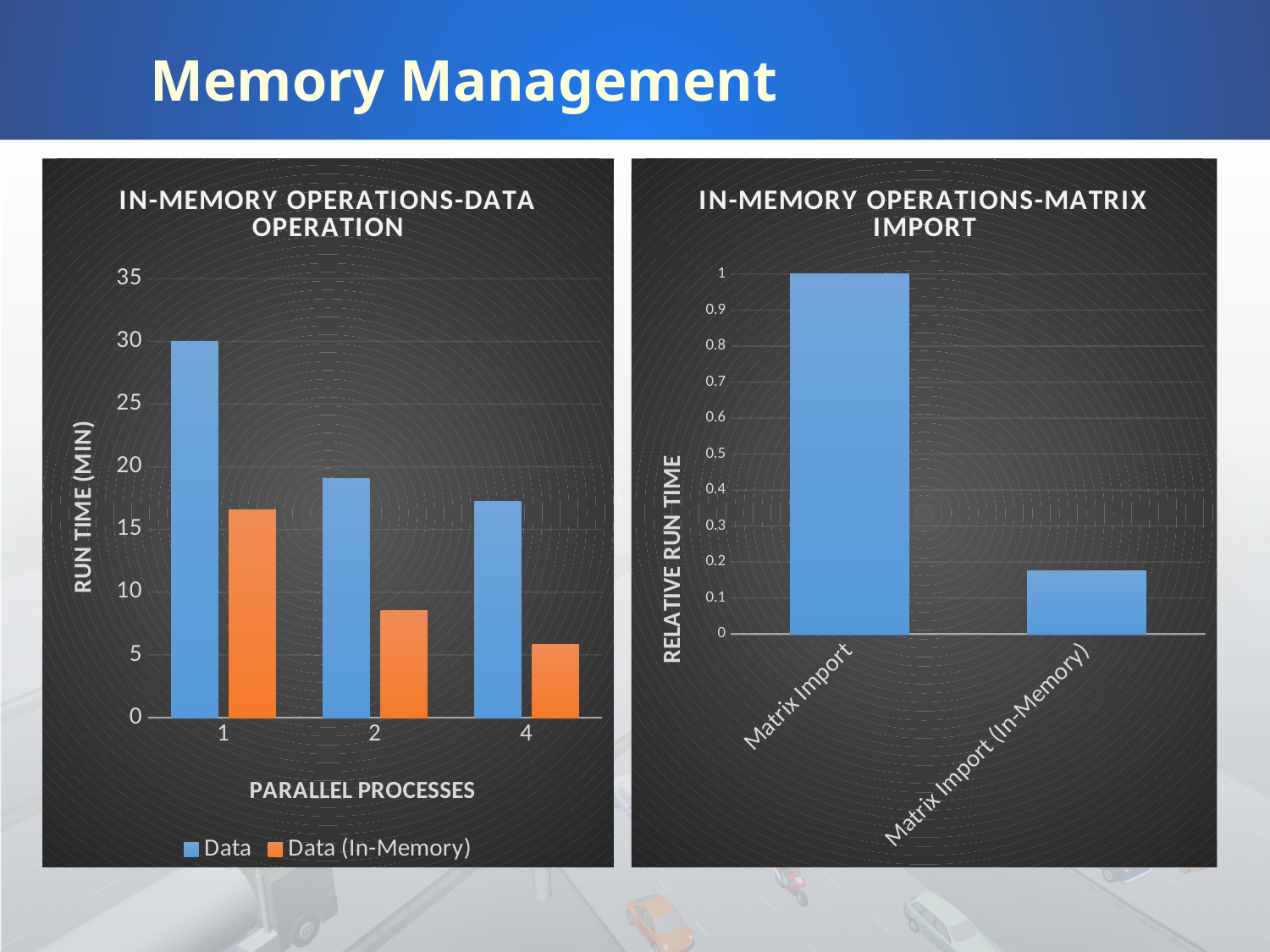
In the 'In-Memory Operations-Data Operation' chart, what kind of chart is shown? bar chart In the 'In-Memory Operations-Data Operation' chart, at which number of parallel processes is the Data series highest? 1 In the 'In-Memory Operations-Data Operation' chart, which series has the larger value at 1 parallel process, Data or Data (In-Memory)? Data In the 'In-Memory Operations-Data Operation' chart, how many parallel process categories are shown on the x axis? 3 In the 'In-Memory Operations-Matrix Import' chart, how many categories are shown? 2 In the 'In-Memory Operations-Data Operation' chart, is the Data (In-Memory) value for 4 parallel processes greater or less than 10? less In the 'In-Memory Operations-Data Operation' chart, what is the y-axis title? RUN TIME (MIN) In the 'In-Memory Operations-Matrix Import' chart, is the value for Matrix Import (In-Memory) greater or less than 0.2? less In the 'In-Memory Operations-Data Operation' chart, does the Data (In-Memory) run time rise or fall as the number of parallel processes increases? fall In the 'In-Memory Operations-Data Operation' chart, how many series does the legend list? 2 In the 'In-Memory Operations-Matrix Import' chart, what is the relative run time for Matrix Import? 1 In the 'In-Memory Operations-Data Operation' chart, is the Data value for 2 parallel processes greater or less than 15? greater